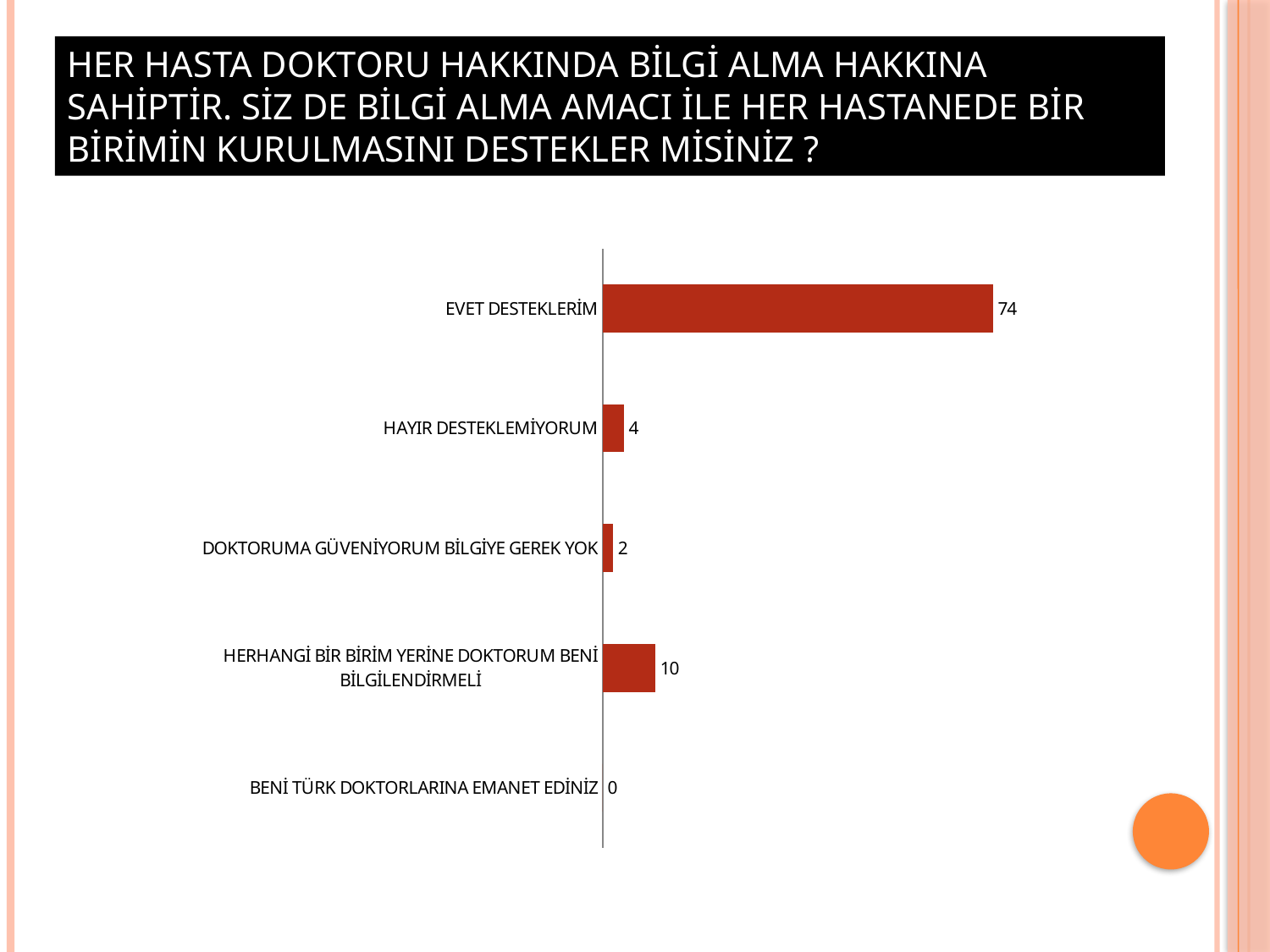
Which category has the highest value? EVET DESTEKLERİM What is the value for HAYIR DESTEKLEMİYORUM? 4 What is the total of all the values shown in the chart? 90 Which is larger, the value for HAYIR DESTEKLEMİYORUM or the value for DOKTORUMA GÜVENİYORUM BİLGİYE GEREK YOK? HAYIR DESTEKLEMİYORUM What kind of chart is shown on the slide? bar chart What is the value for EVET DESTEKLERİM? 74 What is the value for BENİ TÜRK DOKTORLARINA EMANET EDİNİZ? 0 How many categories are shown in the chart? 5 What is the value for DOKTORUMA GÜVENİYORUM BİLGİYE GEREK YOK? 2 Which category has the lowest value? BENİ TÜRK DOKTORLARINA EMANET EDİNİZ What is the difference between the values for EVET DESTEKLERİM and HERHANGİ BİR BİRİM YERİNE DOKTORUM BENİ BİLGİLENDİRMELİ? 64 What is the value for HERHANGİ BİR BİRİM YERİNE DOKTORUM BENİ BİLGİLENDİRMELİ? 10